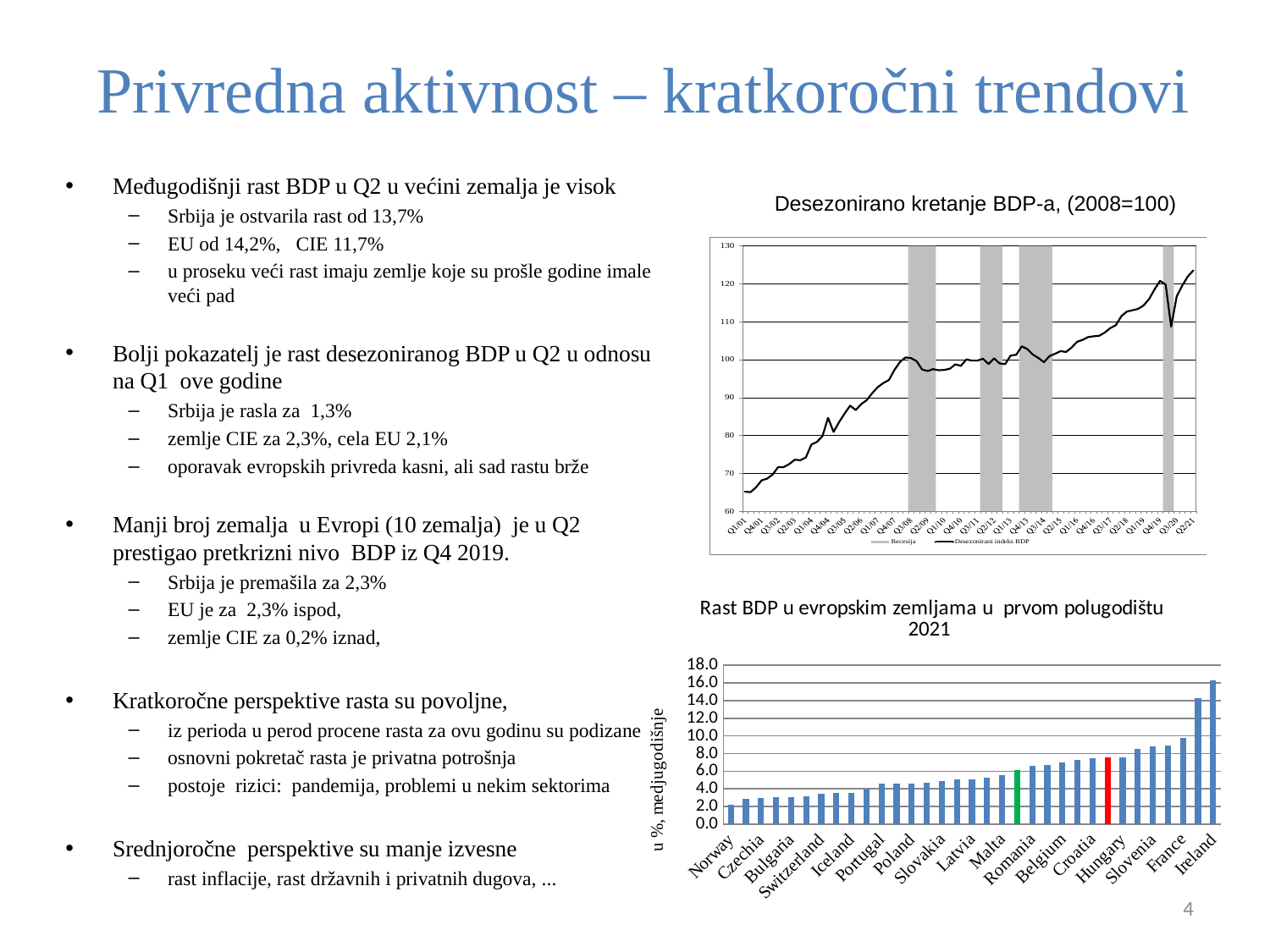
In the chart 'Rast BDP u evropskim zemljama u prvom polugodištu 2021', is the value for France greater or less than 12.0? less In the chart 'Rast BDP u evropskim zemljama u prvom polugodištu 2021', do the values rise or fall from left to right? rise What kind of chart is the chart titled 'Desezonirano kretanje BDP-a, (2008=100)'? line chart In the chart 'Rast BDP u evropskim zemljama u prvom polugodištu 2021', which is larger, the value for Ireland or the value for Czechia? Ireland In the chart 'Rast BDP u evropskim zemljama u prvom polugodištu 2021', is the value for Ireland greater or less than 14.0? greater In the chart 'Rast BDP u evropskim zemljama u prvom polugodištu 2021', which country has the lowest value? Norway In the chart 'Rast BDP u evropskim zemljama u prvom polugodištu 2021', which country has the highest value? Ireland What is the y-axis label of the chart 'Rast BDP u evropskim zemljama u prvom polugodištu 2021'? u %, medjugodišnje How many series does the legend of the chart 'Desezonirano kretanje BDP-a, (2008=100)' list? 2 In the chart 'Rast BDP u evropskim zemljama u prvom polugodištu 2021', is the value for Norway greater or less than 4.0? less What kind of chart is the chart titled 'Rast BDP u evropskim zemljama u prvom polugodištu 2021'? bar chart